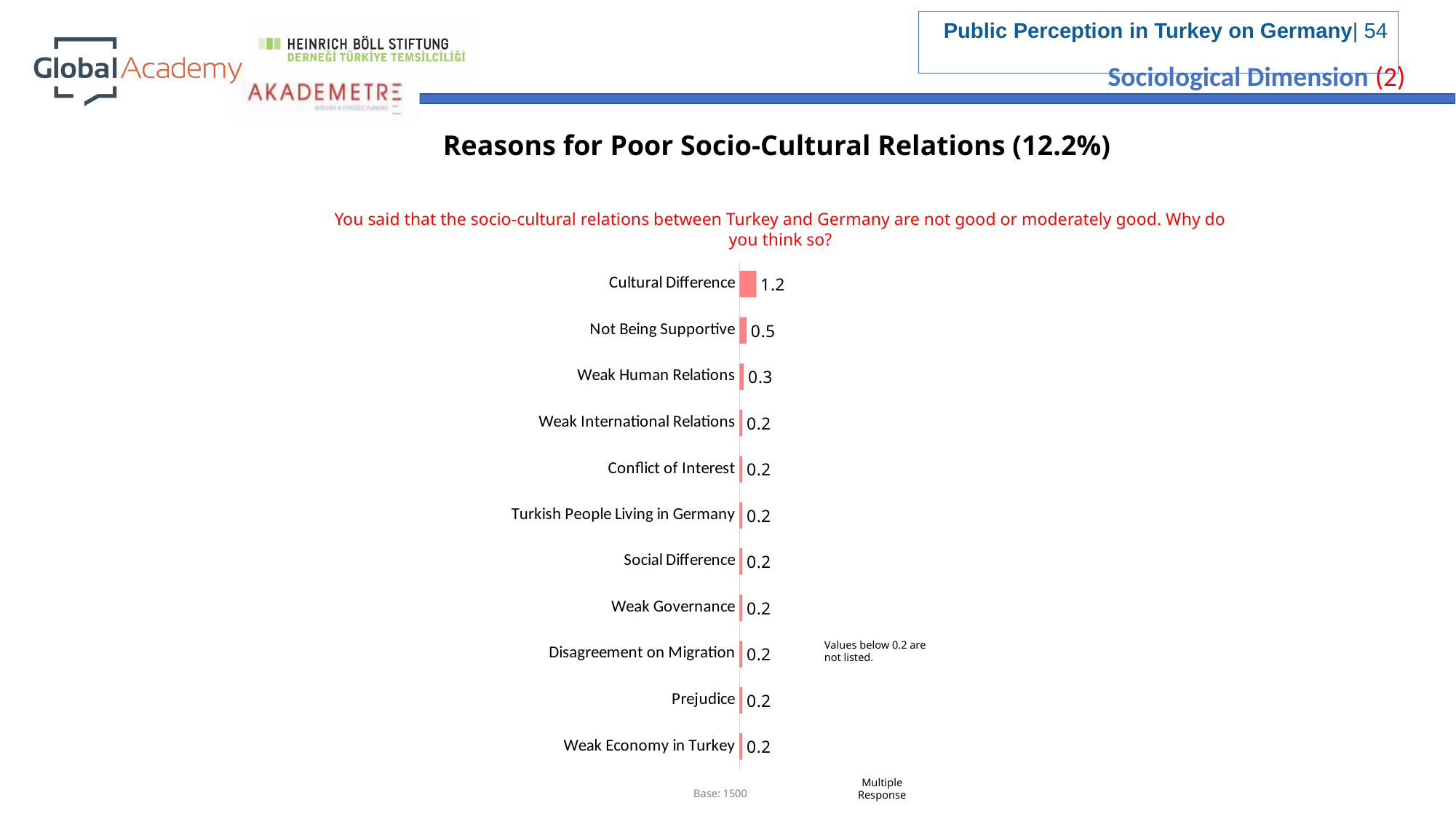
What is the base (sample size) noted below the chart? 1500 What is the difference between the values for Not Being Supportive and Weak Human Relations? 0.2 How many categories have a value of 0.2? 8 What is the value for Weak Human Relations? 0.3 Which is larger, the value for Cultural Difference or the value for Weak Human Relations? Cultural Difference How many categories are shown in the chart? 11 What is the value for Prejudice? 0.2 What is the difference between the values for Cultural Difference and Not Being Supportive? 0.7 What is the value for Not Being Supportive? 0.5 Which category has the highest value? Cultural Difference What kind of chart is shown on the slide? Bar chart What is the value for Cultural Difference? 1.2